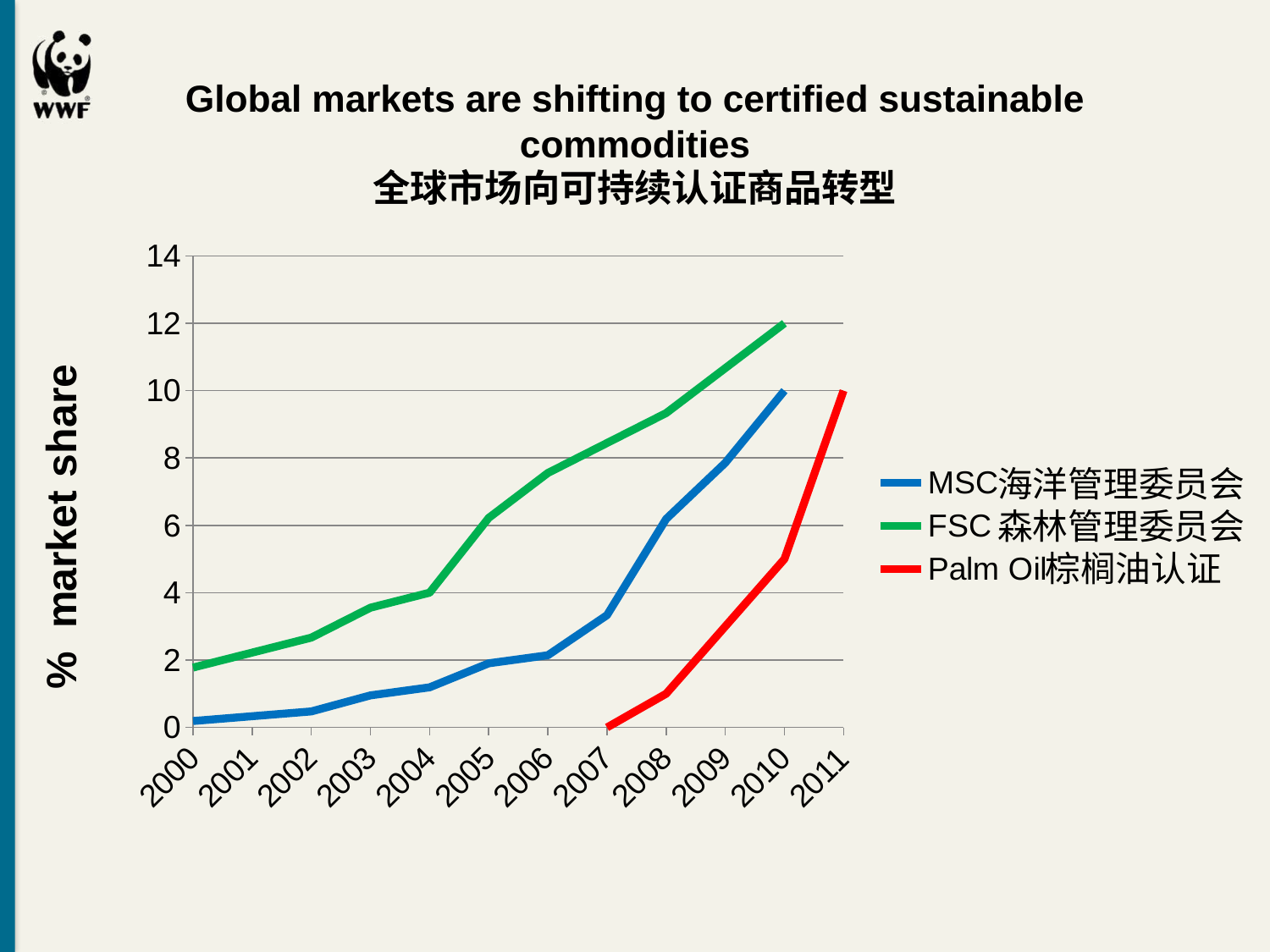
Do the values for MSC海洋管理委员会 rise or fall from 2000 to 2010? rise Which series has the lowest market share in 2008? Palm Oil棕榈油认证 What kind of chart is shown on the slide? line chart How many series does the legend list? 3 How many years are shown on the x axis? 12 What is the label of the y axis? % market share Which series has the highest market share in 2010? FSC 森林管理委员会 Is the value for MSC海洋管理委员会 in 2004 greater or less than 2? less Which series is drawn in red? Palm Oil棕榈油认证 In 2009, which is larger: the value for MSC海洋管理委员会 or the value for Palm Oil棕榈油认证? MSC海洋管理委员会 Is the value for FSC 森林管理委员会 in 2006 greater or less than 6? greater Is the value for FSC 森林管理委员会 in 2008 greater or less than 8? greater